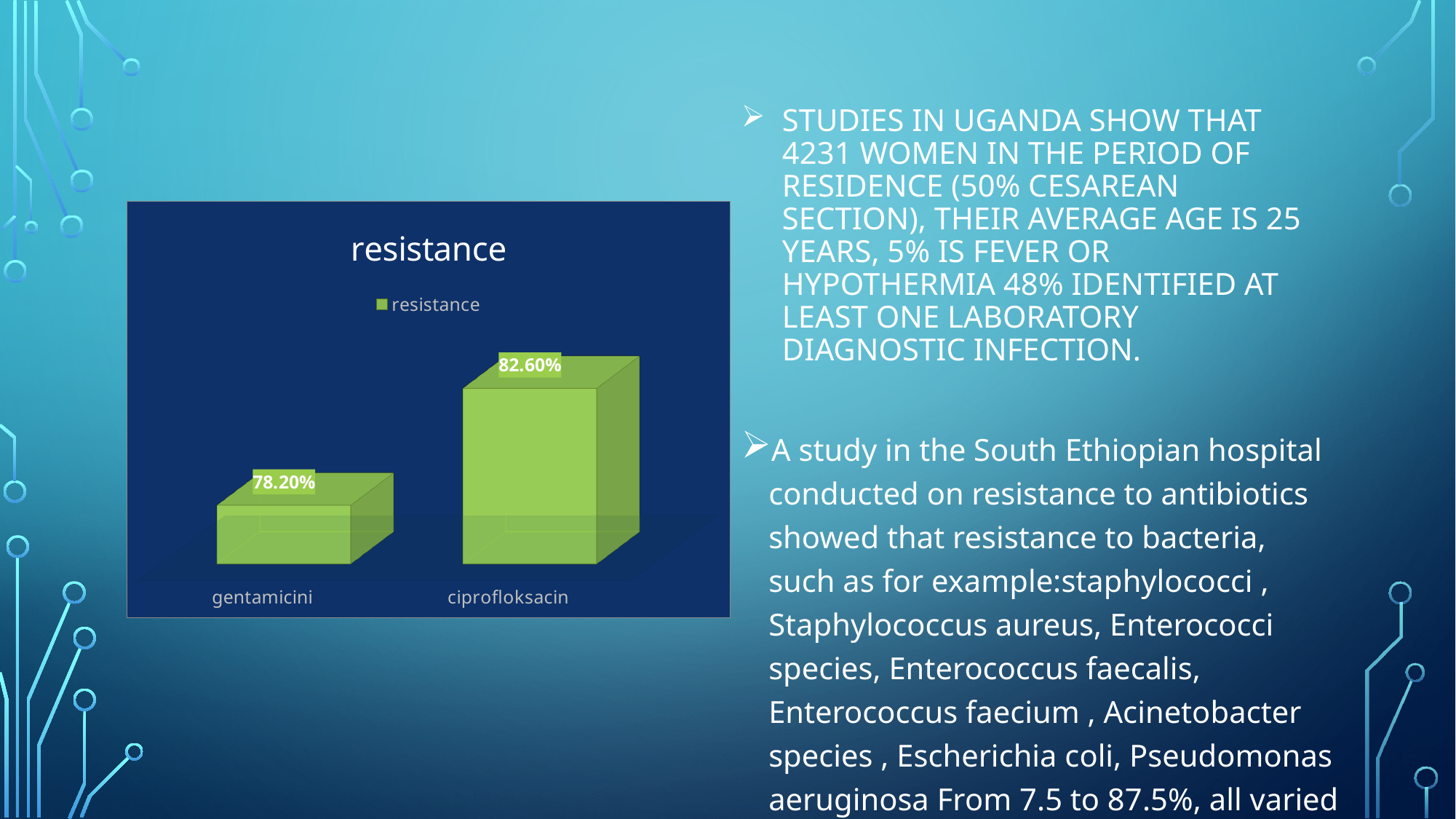
How many series does the legend list? 1 Which has a larger resistance value, gentamicini or ciprofloksacin? ciprofloksacin What is the title of the chart? resistance How many categories are shown in the chart? 2 What is the resistance value for ciprofloksacin? 82.60% Which category has the lowest resistance value? gentamicini Which category has the highest resistance value? ciprofloksacin What is the difference between the resistance values for ciprofloksacin and gentamicini? 4.40% What series name is shown in the chart legend? resistance What kind of chart is shown on the slide? bar chart What is the resistance value for gentamicini? 78.20%